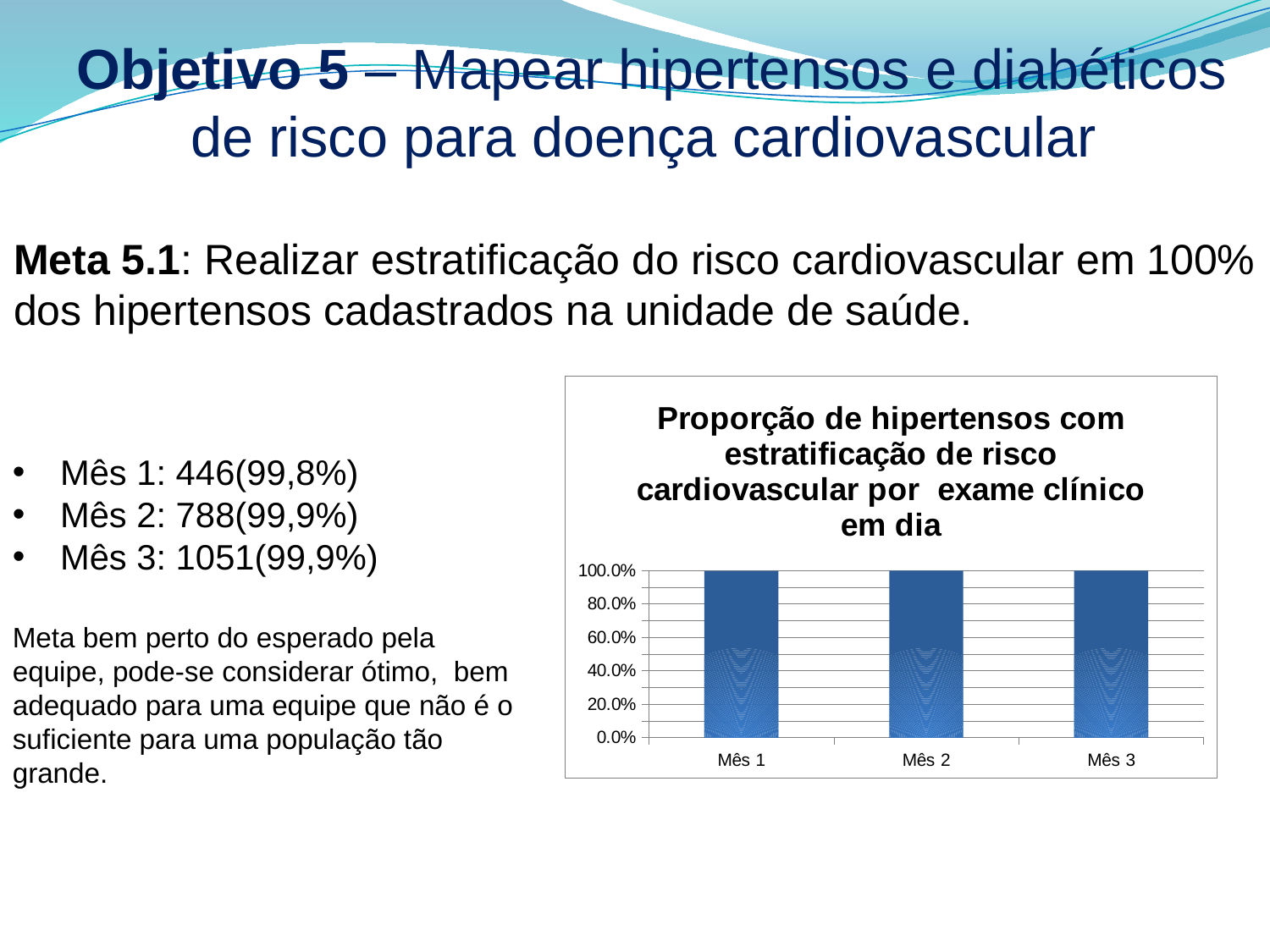
Is the value for Mês 3 greater or less than 80.0%? greater According to the slide text, what percentage is reported for Mês 1? 99,8% According to the slide text, what percentage is reported for Mês 3? 99,9% What is the label of the first category on the x axis? Mês 1 Is the value for Mês 2 greater or less than 60.0%? greater How many categories (months) are plotted on the chart? 3 What is the highest value shown on the chart's vertical axis? 100.0% What is the label of the last category on the x axis? Mês 3 What is the title of the chart? Proporção de hipertensos com estratificação de risco cardiovascular por exame clínico em dia What kind of chart is shown on the slide? bar chart Is the value for Mês 1 greater or less than 80.0%? greater